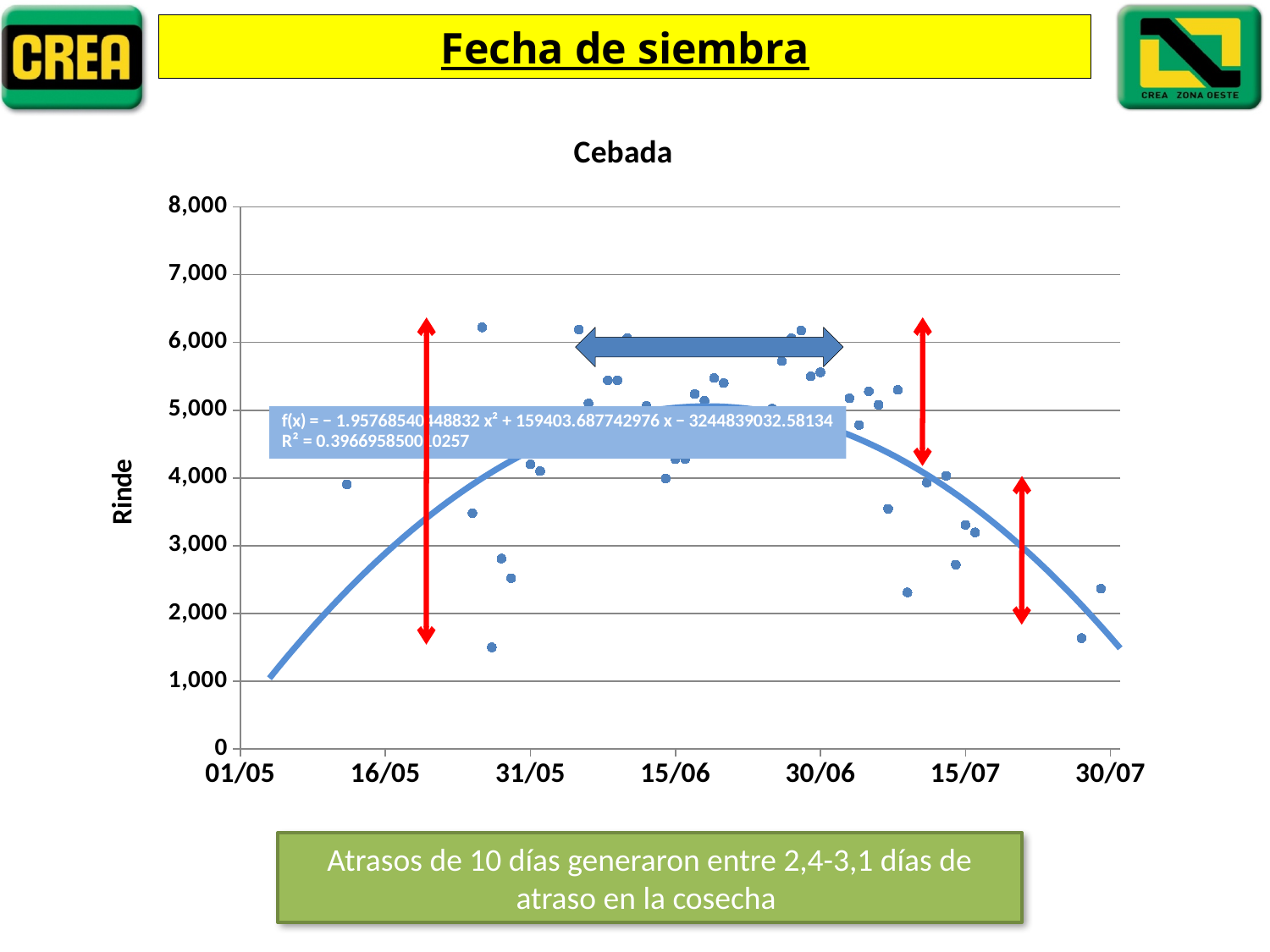
Does the fitted trend line rise or fall as the dates move from 30/06 to 30/07? fall Is the value of the lowest data point on the chart (near the end of May) greater or less than 2,000? less Is the value of the highest data point on the chart greater or less than 6,000? greater What is the label on the vertical axis of the chart? Rinde How many date tick labels are shown on the horizontal axis of the chart? 7 What is the first date shown on the horizontal axis of the chart? 01/05 What is the title of the chart? Cebada Does the fitted trend line rise or fall as the dates move from 01/05 to 31/05? rise Is the value of the last data point on the chart (near 30/07) greater or less than 3,000? less What is the highest value shown on the vertical axis of the chart? 8,000 What kind of chart is shown on the slide? scatter chart What is the last date shown on the horizontal axis of the chart? 30/07